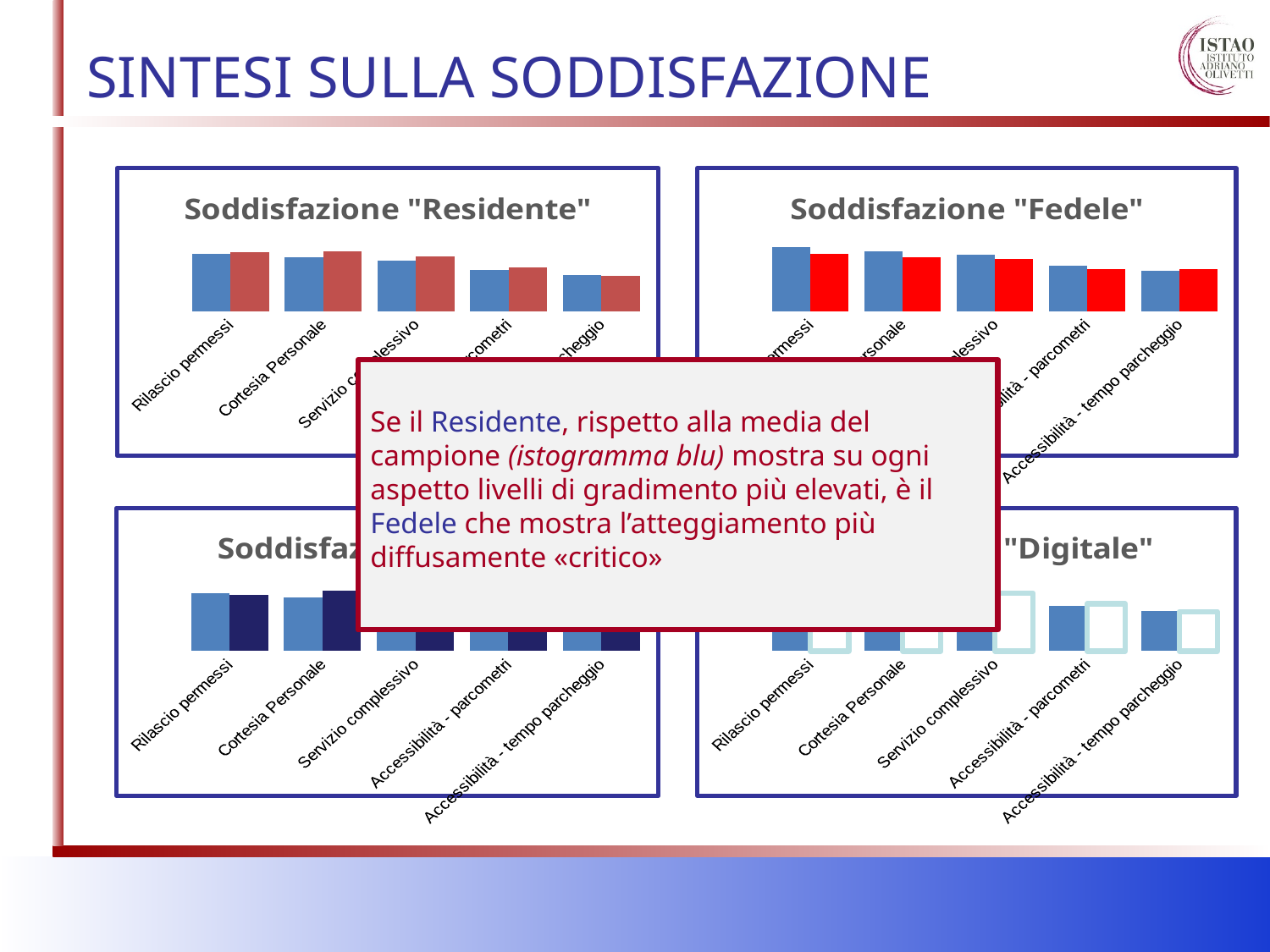
How many categories are shown on the x axis of the "Soddisfazione "Fedele"" chart? 5 In the "Soddisfazione "Fedele"" chart, do the blue bars rise or fall from left to right along the x axis? fall In the "Soddisfazione "Residente"" chart, which bar is taller for Cortesia Personale, the blue one or the red one? the red one How many bars are plotted for each category in the "Soddisfazione "Fedele"" chart? 2 What is the first category on the x axis of the bottom-left chart? Rilascio permessi In the "Soddisfazione "Fedele"" chart, which bar is taller for Rilascio permessi, the blue one or the red one? the blue one In the "Soddisfazione "Fedele"" chart, which category has the shortest blue bar? Accessibilità - tempo parcheggio How many categories are shown on the x axis of the bottom-left chart? 5 In the "Soddisfazione "Residente"" chart, do the blue bars rise or fall from left to right along the x axis? fall What kind of chart is the "Soddisfazione "Residente"" chart at the top left? bar chart What is the title of the top-left chart? Soddisfazione "Residente" In the "Soddisfazione "Fedele"" chart, which category has the tallest blue bar? Rilascio permessi